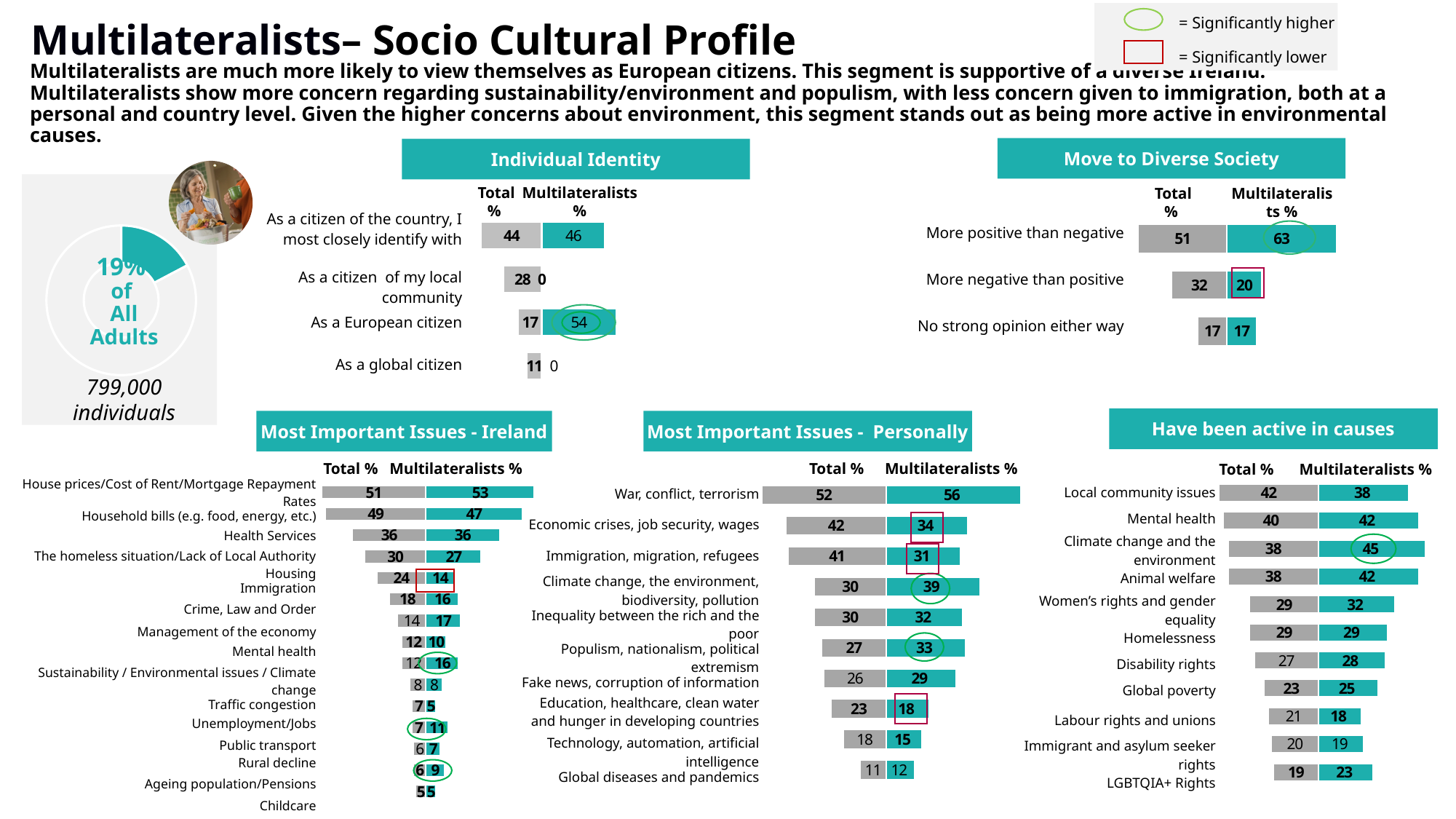
In the Have been active in causes chart, which cause has the lowest Total %? LGBTQIA+ Rights In the Most Important Issues - Ireland chart, which issue has the highest Multilateralists %? House prices/Cost of Rent/Mortgage Repayment Rates In the Individual Identity chart, what is the Total % for 'As a citizen of the country, I most closely identify with'? 44 In the Most Important Issues - Personally chart, what is the Multilateralists % for 'Climate change, the environment, biodiversity, pollution'? 39 In the Move to Diverse Society chart, what is the difference between the Total % and Multilateralists % for 'More negative than positive'? 12 In the Have been active in causes chart, what is the Multilateralists % for 'Climate change and the environment'? 45 In the Move to Diverse Society chart, how many categories are shown? 3 What kind of chart is used for the Most Important Issues - Personally section? Bar chart In the Most Important Issues - Personally chart, which is larger for 'Economic crises, job security, wages': the Total % or the Multilateralists %? Total % In the Most Important Issues - Ireland chart, what is the Multilateralists % for Immigration? 14 In the Move to Diverse Society chart, what is the Multilateralists % for 'More positive than negative'? 63 In the Individual Identity chart, what is the Multilateralists % for 'As a European citizen'? 54